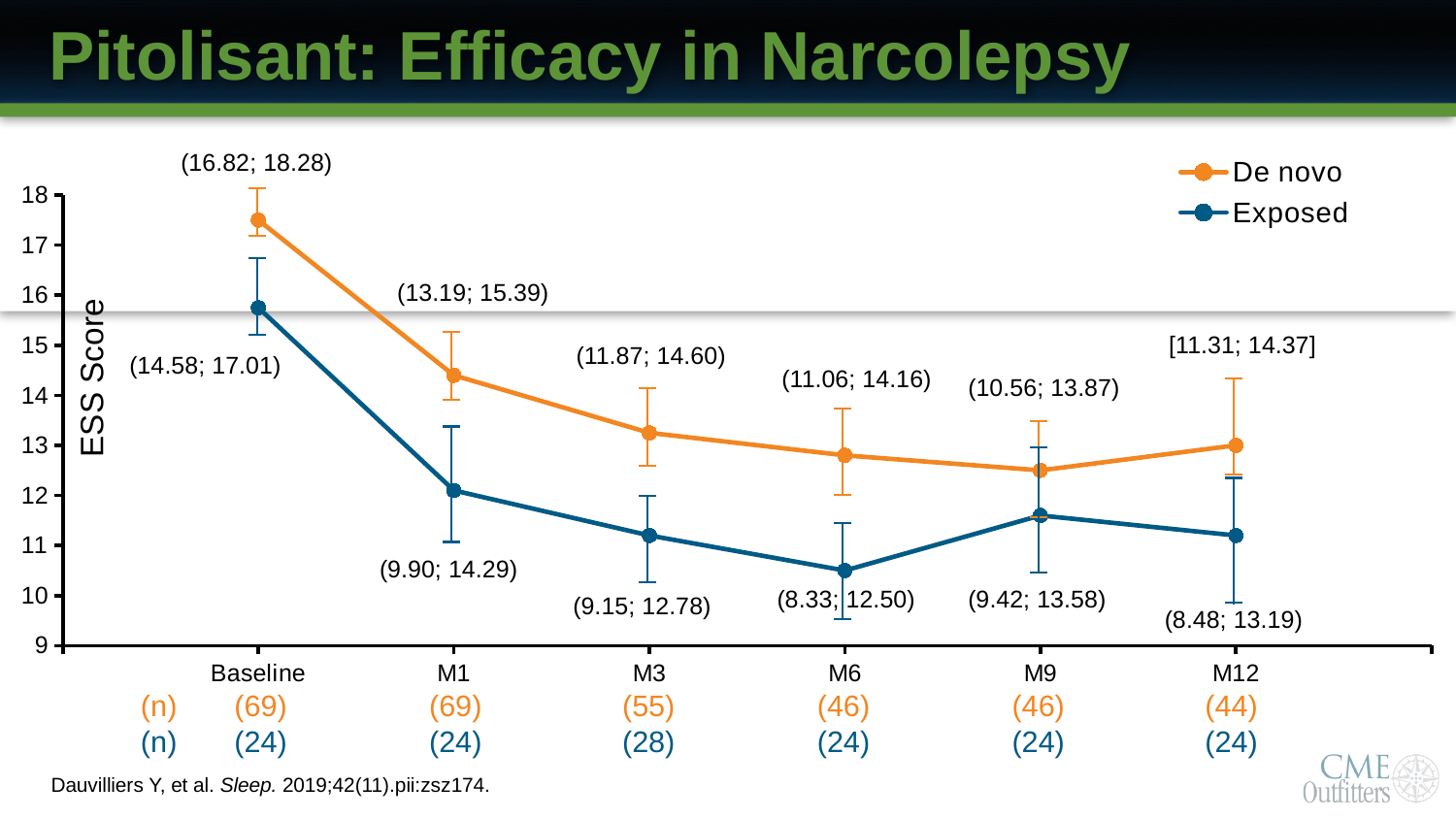
What interval is printed for the Exposed series at M6? (8.33; 12.50) What kind of chart is shown on the slide? line chart Do the De novo values rise or fall from Baseline to M6? fall Is the De novo value at Baseline greater or less than 17? greater What interval is printed for the De novo series at Baseline? (16.82; 18.28) At which time point is the Exposed series at its highest? Baseline What is the y-axis label of the chart? ESS Score Is the Exposed value at M6 greater or less than 11? less How many series does the legend list? 2 What are the two series named in the legend? De novo and Exposed At M1, which series has the higher ESS Score, De novo or Exposed? De novo How many time points are plotted along the x axis? 6